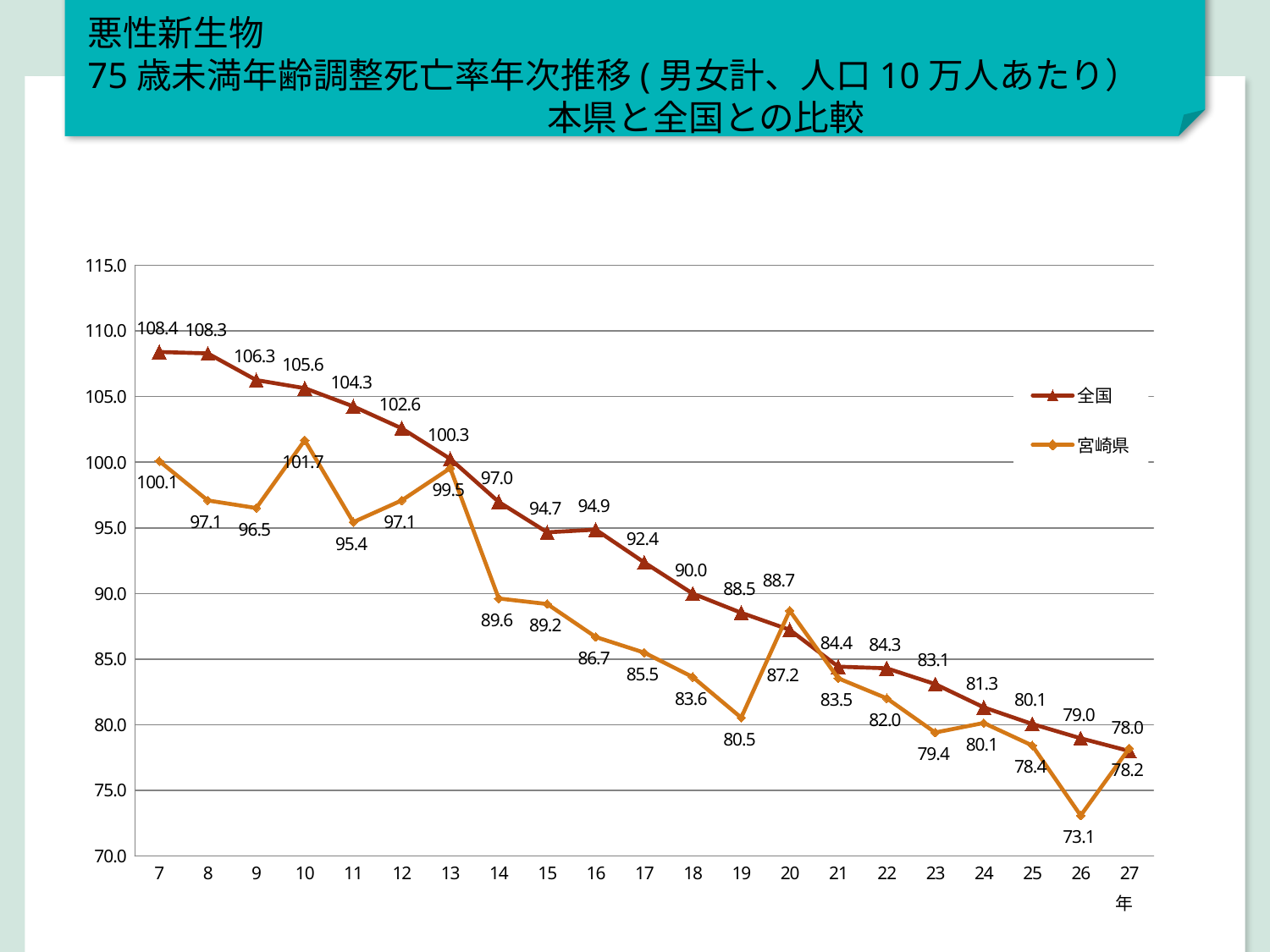
In which year is the 宮崎県 value lowest? 26 Is the value for 宮崎県 in year 10 greater or less than 100? greater What kind of chart is shown on the slide? line chart What is the difference between the 全国 and 宮崎県 values in year 13? 0.8 In which year is the 全国 value highest? 7 What is the value for 全国 in year 27? 78.0 What is the value for 全国 in year 7? 108.4 Does the 全国 series generally rise or fall from year 7 to year 27? fall In year 20, which series has the larger value, 全国 or 宮崎県? 宮崎県 How many years are plotted on the x axis? 21 How many series does the legend list? 2 What is the value for 宮崎県 in year 26? 73.1